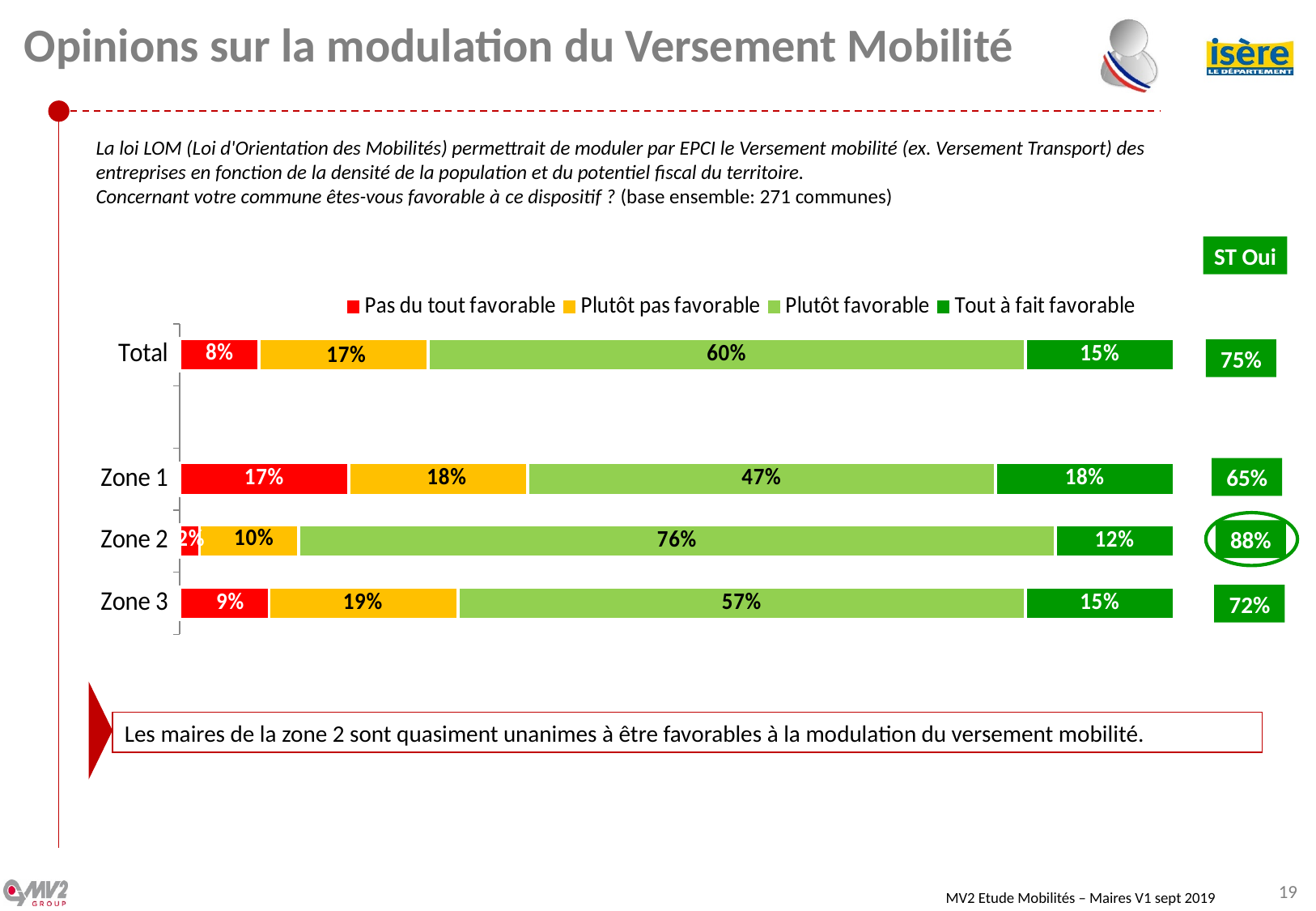
Which category has the highest value for "Plutôt favorable"? Zone 2 Which is larger: "Plutôt pas favorable" for Zone 3 or for Zone 2? Zone 3 What is the difference between the "Plutôt favorable" values for Zone 2 and Zone 1? 29% Which legend entry is shown in red? Pas du tout favorable What is the value of "Tout à fait favorable" for Total? 15% How many series does the legend list? 4 Which category has the lowest value for "Pas du tout favorable"? Zone 2 What is the value of "Plutôt pas favorable" for Zone 3? 19% How many categories (bars) are plotted in the chart? 4 What kind of chart is shown on the slide? Stacked bar chart What is the value of "Pas du tout favorable" for Zone 1? 17% What is the value of "Plutôt favorable" for Zone 2? 76%